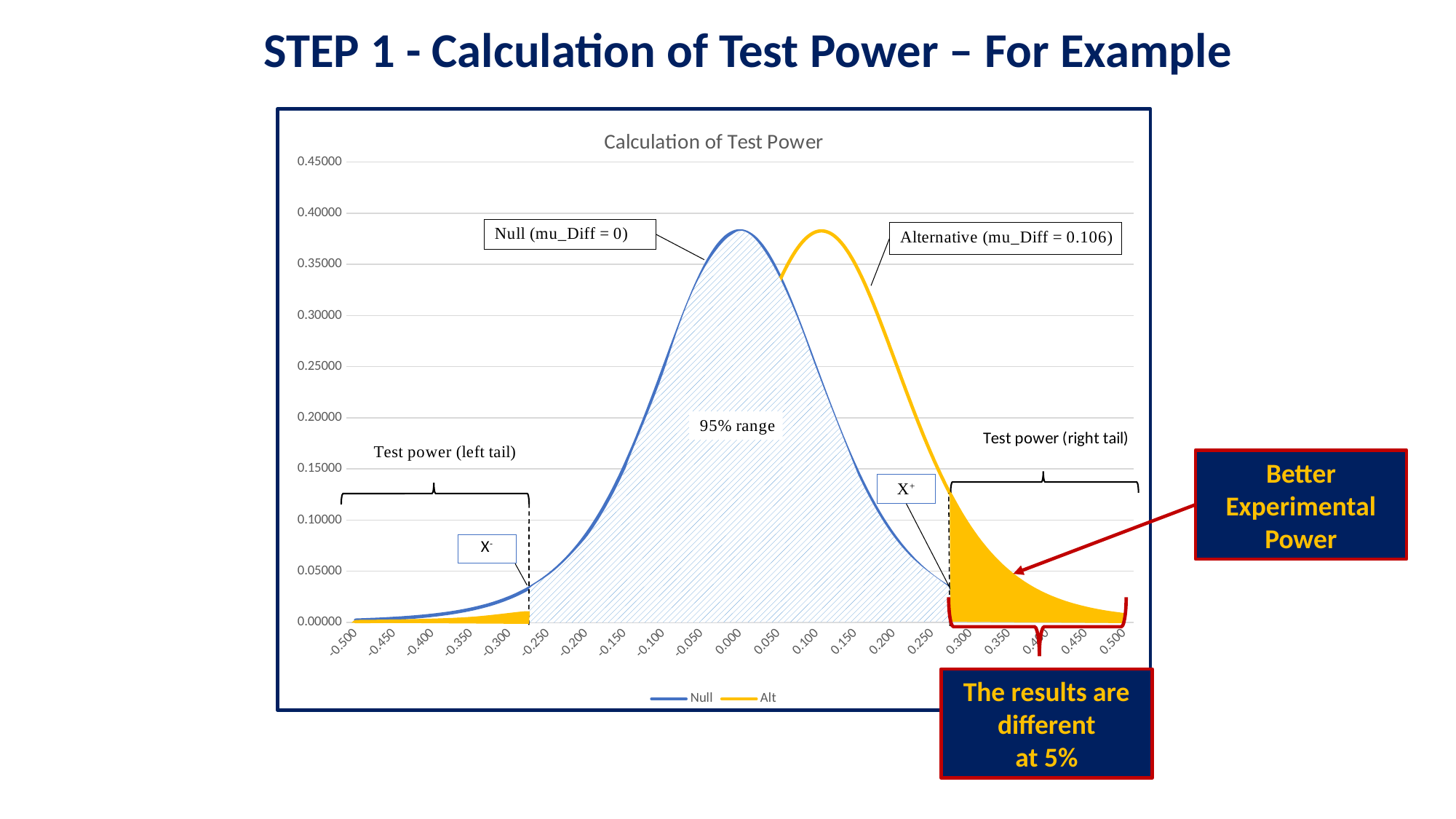
What is the title of the chart? Calculation of Test Power How many series does the legend list? 2 Is the peak value of the Null curve greater or less than 0.35000? greater What mu_Diff value is given for the Null curve in the annotation? 0 What mu_Diff value is given for the Alternative curve in the annotation? 0.106 What is the highest value labelled on the y axis? 0.45000 Which series has its peak further to the right on the x axis, Null or Alt? Alt Which colour is used for the Alt series? Yellow How many tick labels are shown on the x axis? 21 Is the value of the Null curve at x = 0.300 greater or less than 0.05000? less Is the peak value of the Alt curve greater or less than 0.40000? less What kind of chart is shown on the slide? Line chart